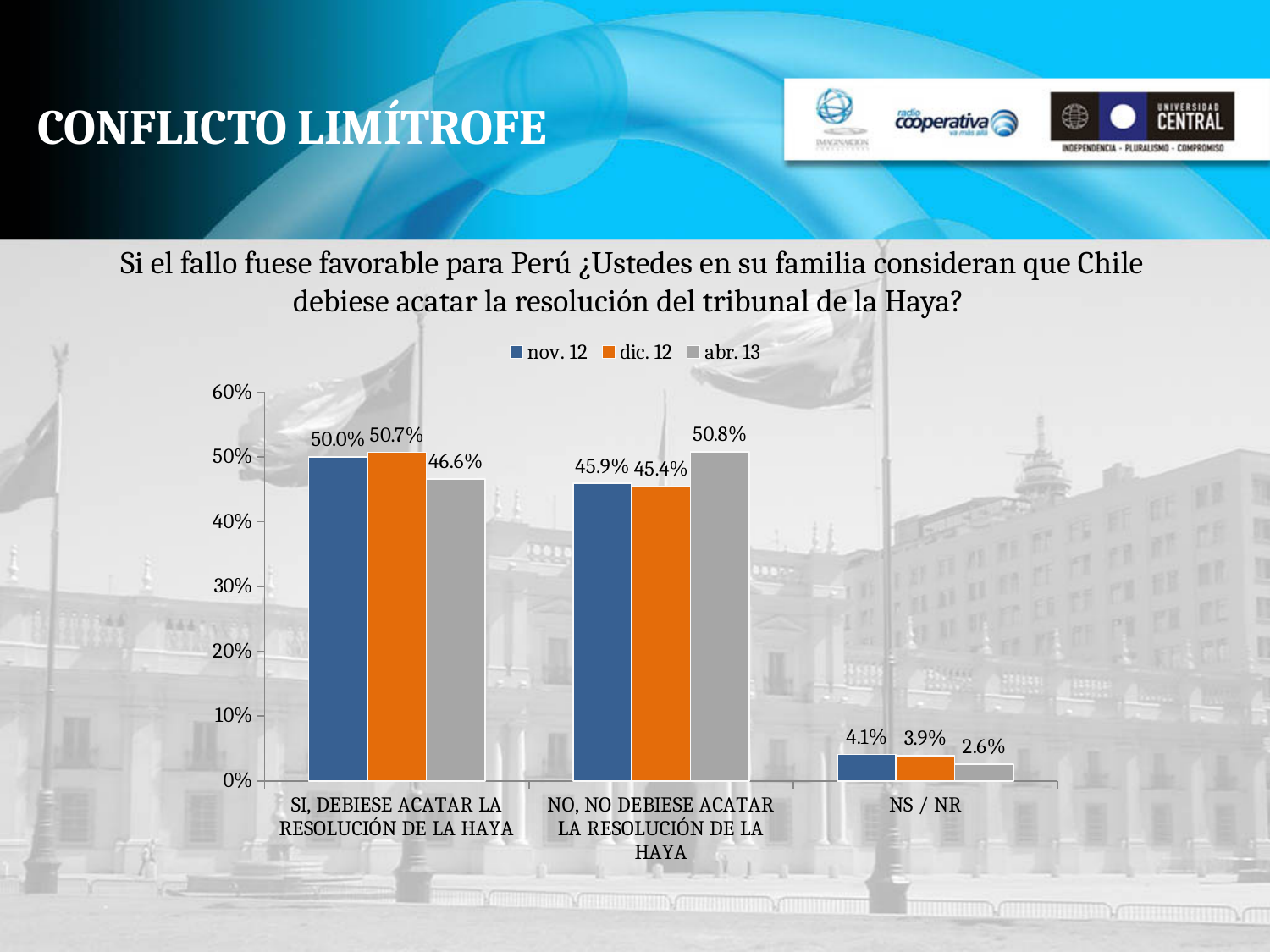
What is the value for "NS / NR" in the dic. 12 series? 3.9% Which category has the highest value in the dic. 12 series? SI, DEBIESE ACATAR LA RESOLUCIÓN DE LA HAYA Which is larger for "SI, DEBIESE ACATAR LA RESOLUCIÓN DE LA HAYA": the dic. 12 value or the abr. 13 value? dic. 12 What is the difference between the abr. 13 and nov. 12 values for "NO, NO DEBIESE ACATAR LA RESOLUCIÓN DE LA HAYA"? 4.9% What is the value for "NO, NO DEBIESE ACATAR LA RESOLUCIÓN DE LA HAYA" in the abr. 13 series? 50.8% Is the nov. 12 value for "NO, NO DEBIESE ACATAR LA RESOLUCIÓN DE LA HAYA" greater or less than 40%? greater Which series is shown in orange in the legend? dic. 12 What kind of chart is shown on the slide? bar chart How many series does the legend list? 3 How many categories are shown on the x axis of the chart? 3 What is the value for "SI, DEBIESE ACATAR LA RESOLUCIÓN DE LA HAYA" in the nov. 12 series? 50.0% Which category has the lowest value in the abr. 13 series? NS / NR